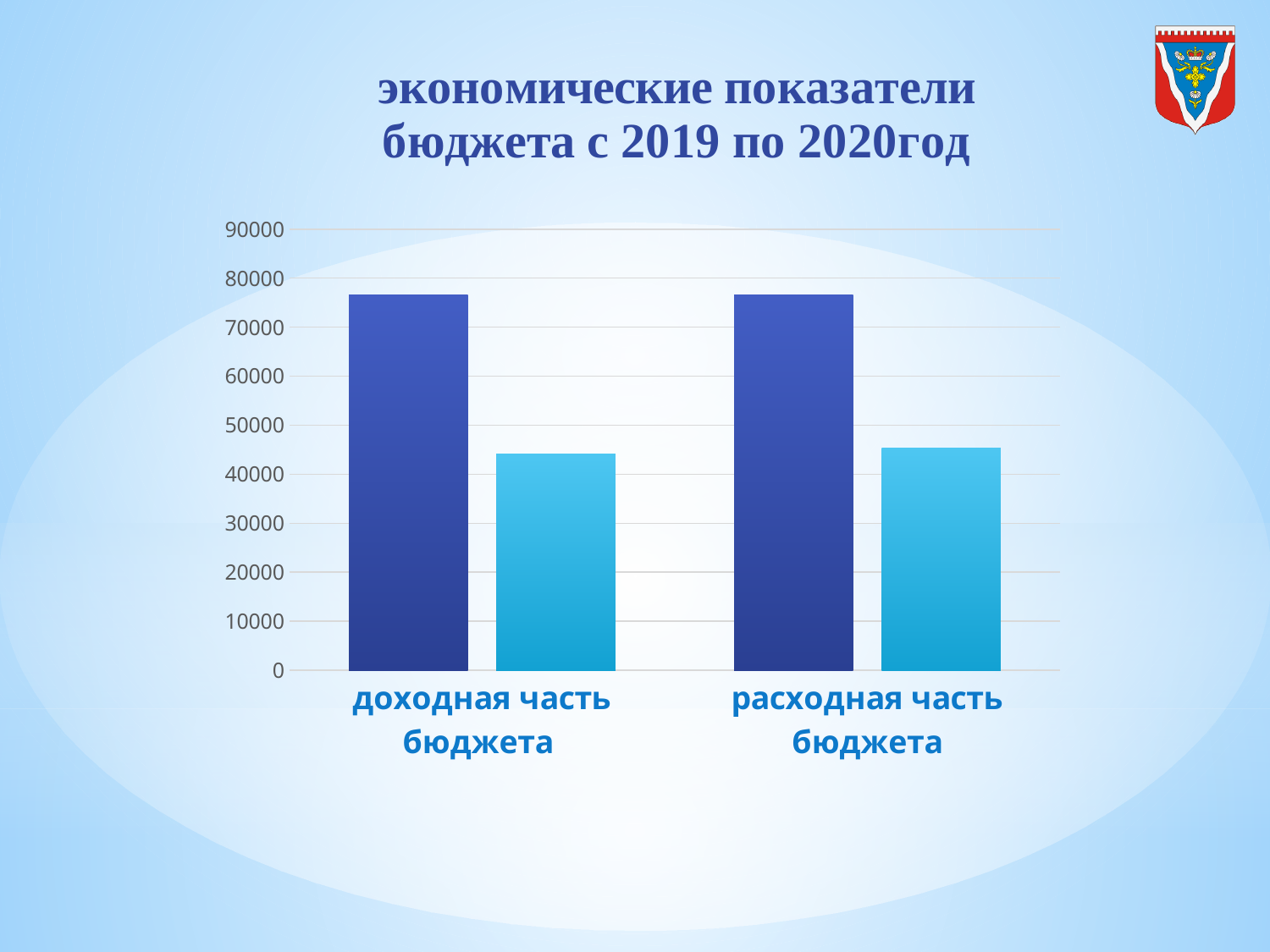
For 'доходная часть бюджета', which bar is larger: the dark blue one or the light blue one? the dark blue one Is the value of the dark blue bar for 'доходная часть бюджета' greater or less than 70000? greater Is the value of the light blue bar for 'расходная часть бюджета' greater or less than 50000? less Is the value of the dark blue bar for 'расходная часть бюджета' greater or less than 70000? greater What is the title of the slide containing the chart? экономические показатели бюджета с 2019 по 2020год For 'расходная часть бюджета', which bar is larger: the dark blue one or the light blue one? the dark blue one How many bars are plotted in total on the chart? 4 What kind of chart is shown on the slide? bar chart How many categories are shown on the x axis of the chart? 2